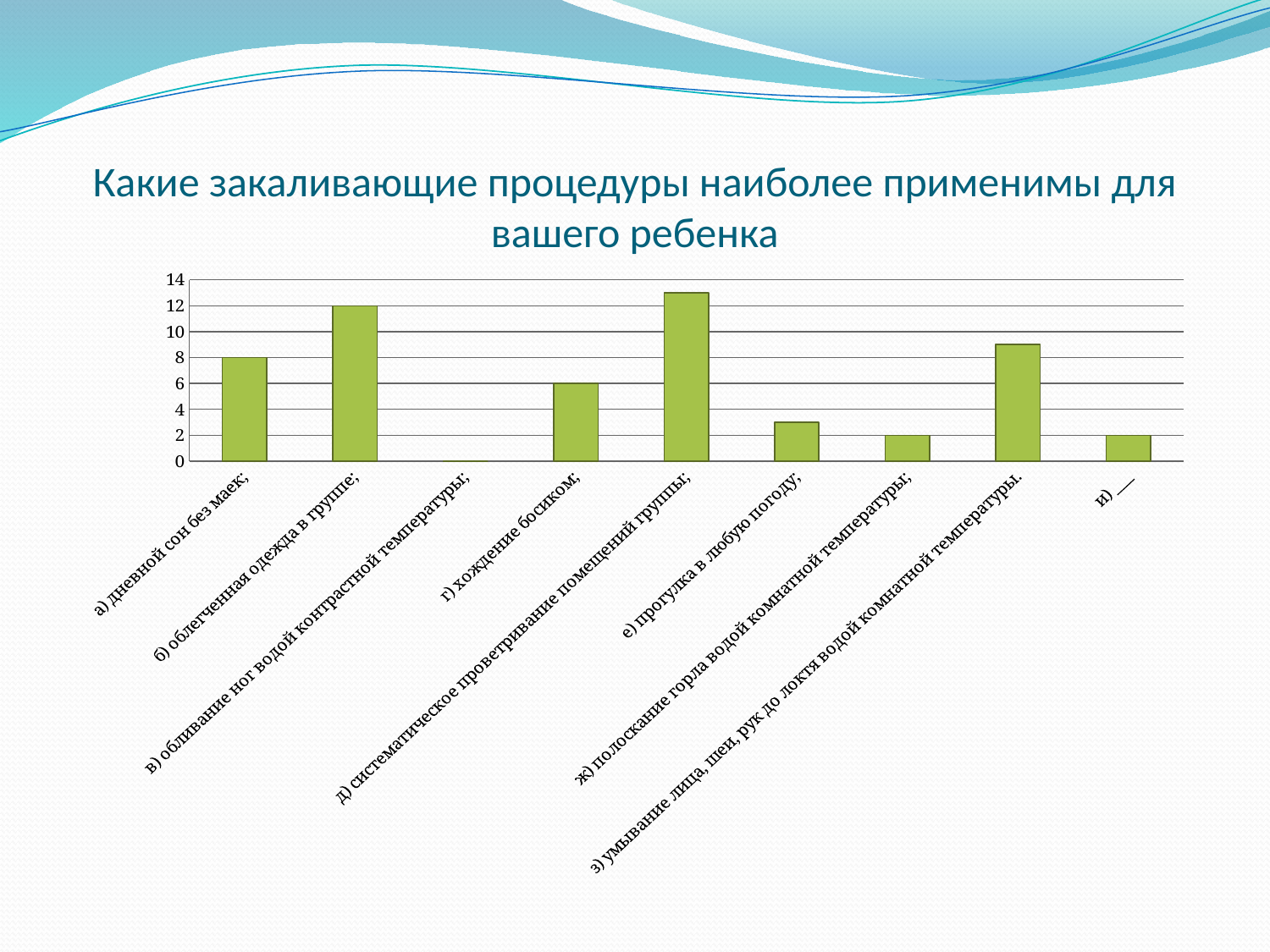
Which category has the highest value? д) систематическое проветривание помещений группы What kind of chart is shown on the slide? bar chart What is the difference between the values for "б) облегченная одежда в группе" and "а) дневной сон без маек"? 4 What is the value for "г) хождение босиком"? 6 Is the value for "д) систематическое проветривание помещений группы" greater or less than 12? greater Which category has the lowest value? в) обливание ног водой контрастной температуры Is the value for "з) умывание лица, шеи, рук до локтя водой комнатной температуры" greater or less than 10? less What is the value for "а) дневной сон без маек"? 8 How many categories are shown on the x axis? 9 What is the value for "б) облегченная одежда в группе"? 12 Which is larger, the value for "б) облегченная одежда в группе" or for "з) умывание лица, шеи, рук до локтя водой комнатной температуры"? б) облегченная одежда в группе What is the value for "ж) полоскание горла водой комнатной температуры"? 2